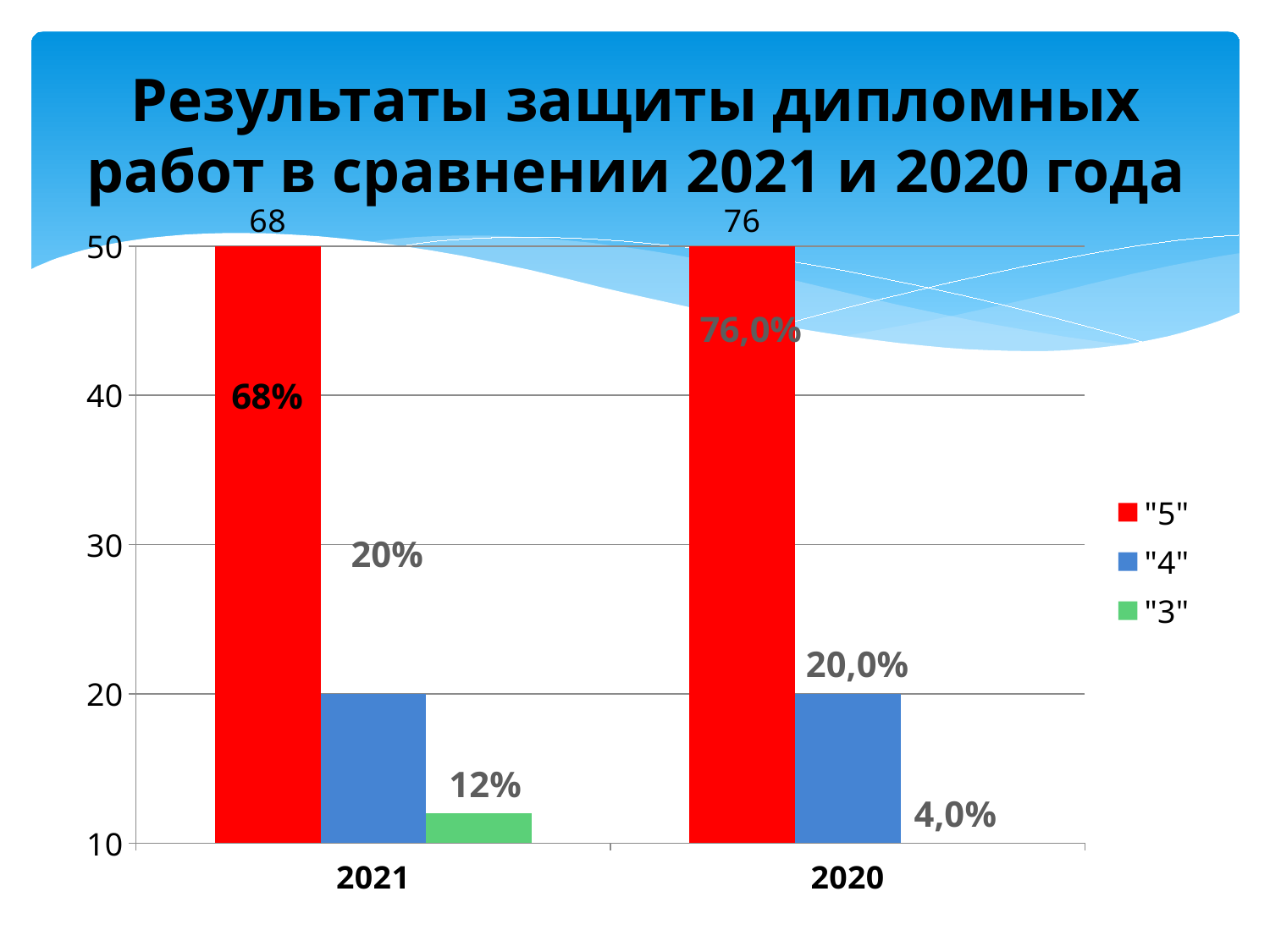
What is the value for the "5" series in 2020? 76,0% Which series has the highest value in 2021? "5" What kind of chart is shown on the slide? bar chart What is the difference between the "5" series values for 2020 and 2021? 8 What is the value for the "4" series in 2020? 20,0% What is the value for the "3" series in 2020? 4,0% Which series has the lowest value in 2020? "3" What is the value for the "3" series in 2021? 12% How many series does the legend list? 3 What is the value for the "5" series in 2021? 68% Which year has the larger value for the "5" series, 2021 or 2020? 2020 How many year categories are shown on the x axis? 2